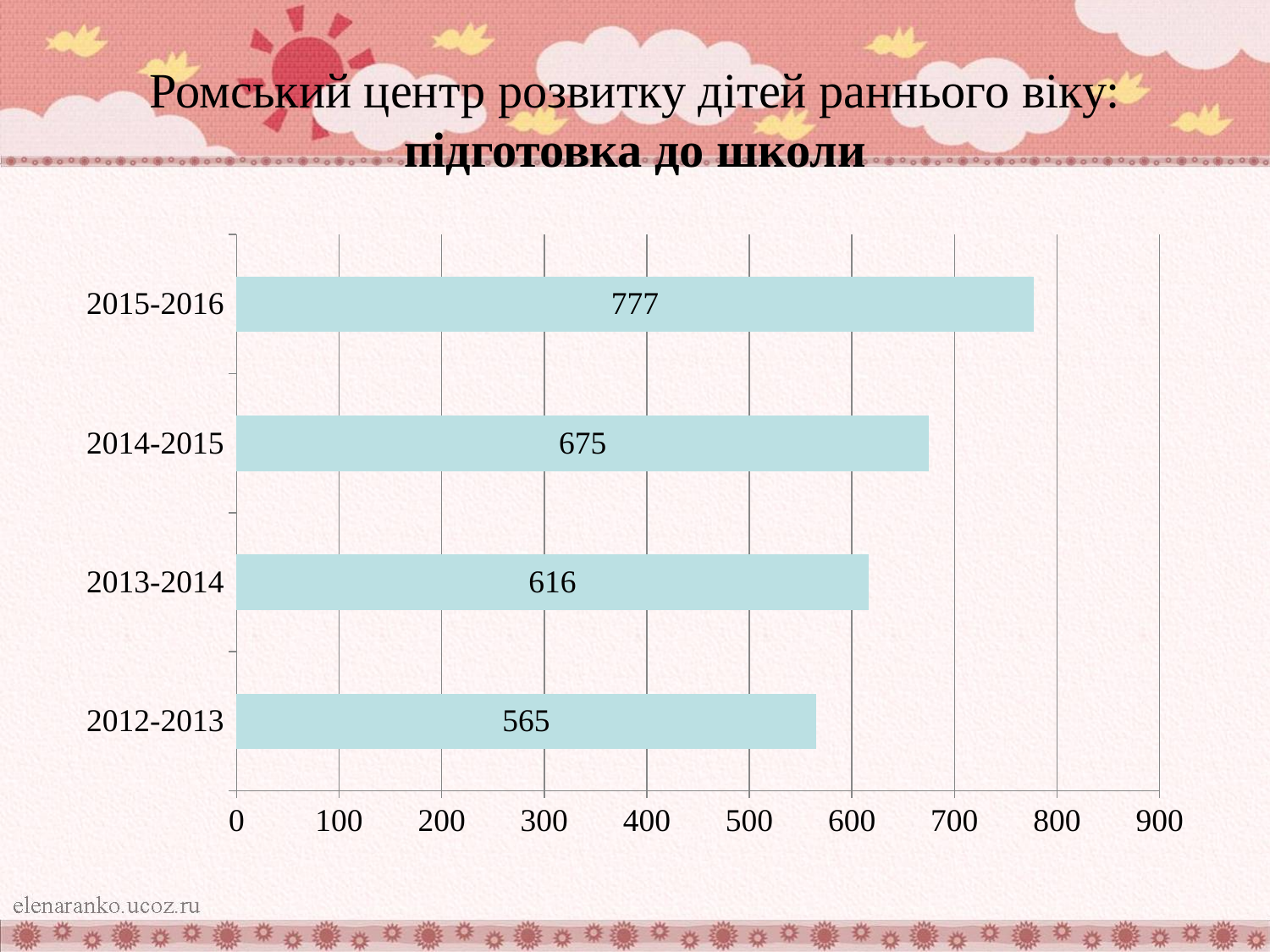
What is the value for 2012-2013? 565 What is the value for 2015-2016? 777 What is the difference between the values for 2013-2014 and 2012-2013? 51 How many periods are shown in the chart? 4 What kind of chart is shown on the slide? bar chart What is the value for 2013-2014? 616 Which period has the highest value? 2015-2016 Which is larger, the value for 2014-2015 or the value for 2013-2014? 2014-2015 Is the value for 2014-2015 greater or less than 600? greater Which period has the lowest value? 2012-2013 What is the difference between the values for 2015-2016 and 2014-2015? 102 Do the values rise or fall from 2012-2013 to 2015-2016? rise